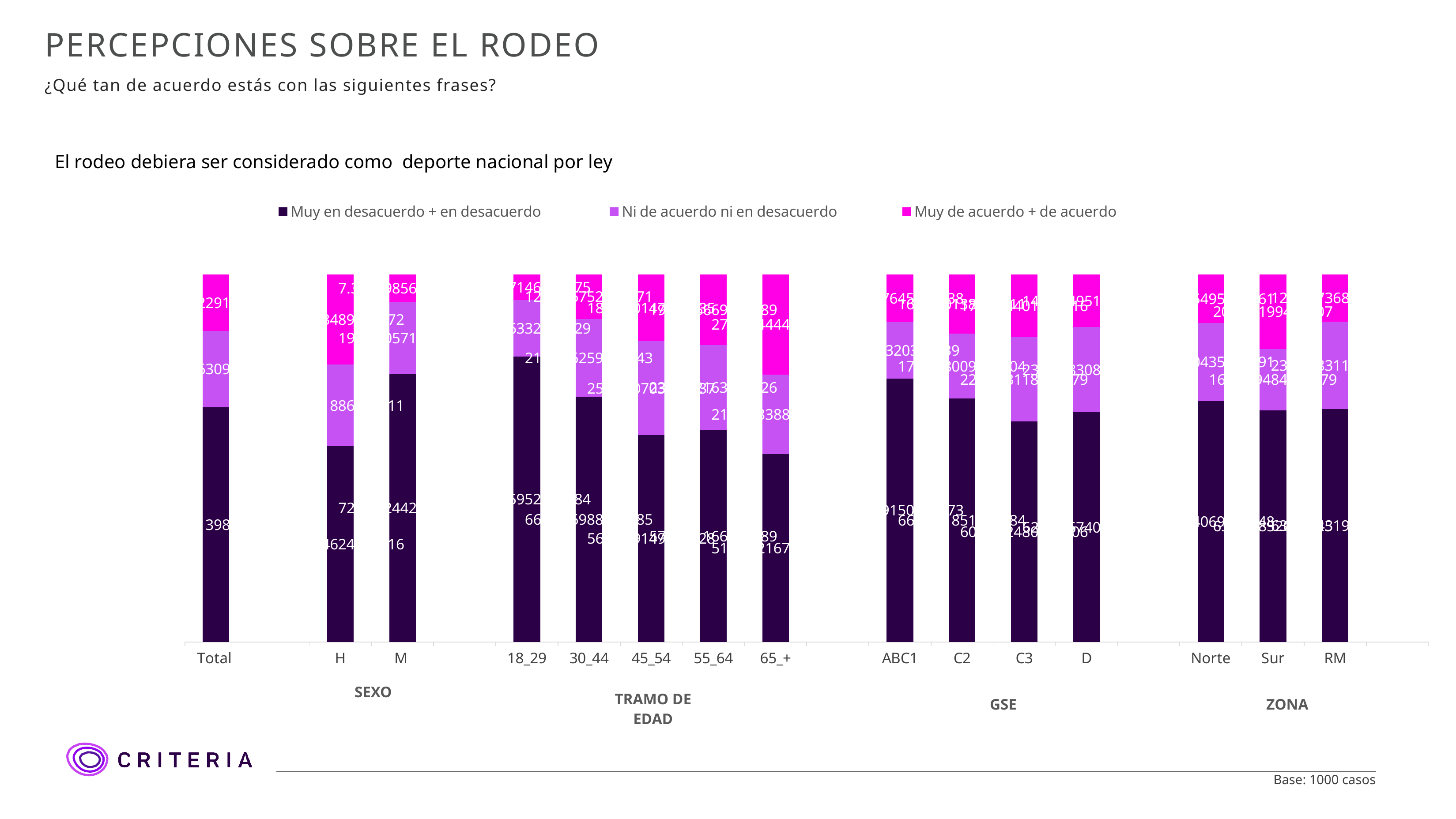
Across the age groups from 18_29 to 65_+, does the 'Muy de acuerdo + de acuerdo' segment generally rise or fall? rise Which legend entry is shown in bright pink/magenta? Muy de acuerdo + de acuerdo Which age group has the largest 'Muy en desacuerdo + en desacuerdo' segment? 18_29 Which age group has the largest 'Muy de acuerdo + de acuerdo' segment? 65_+ What kind of chart is shown on the slide? Stacked bar chart Is the 'Muy de acuerdo + de acuerdo' segment larger for H or for M? H Is the 'Ni de acuerdo ni en desacuerdo' segment larger for H or for 18_29? H Is the 'Muy en desacuerdo + en desacuerdo' segment larger for 18_29 or for 65_+? 18_29 What statement is the chart about, as given in its title? El rodeo debiera ser considerado como deporte nacional por ley How many series does the legend list? 3 How many bars (categories) are plotted along the x axis? 15